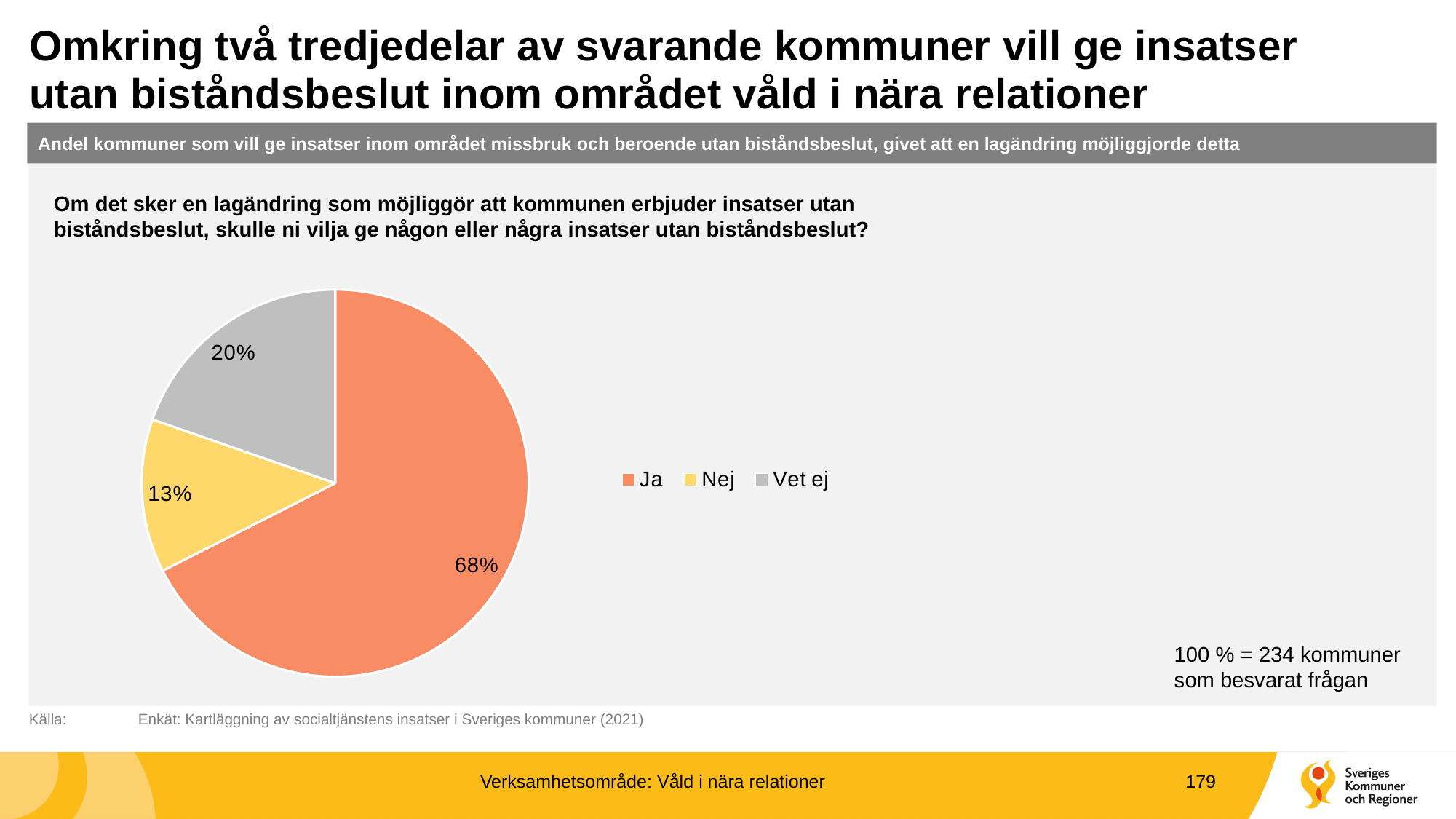
What kind of chart is shown on the slide? Pie chart Which category has the largest slice of the pie? Ja What share of the pie does the "Nej" slice represent? 13% How many municipalities (kommuner) answered the question, according to the note on the slide? 234 What colour is the "Ja" slice in the pie chart? Orange What share of the pie does the "Vet ej" slice represent? 20% How many categories does the pie chart show? 3 What is the difference in percentage points between the "Ja" and "Vet ej" slices? 48 What share of the pie does the "Ja" slice represent? 68% What is the difference in percentage points between the "Vet ej" and "Nej" slices? 7 Which category has the smallest slice of the pie? Nej Which slice is larger, "Nej" or "Vet ej"? Vet ej